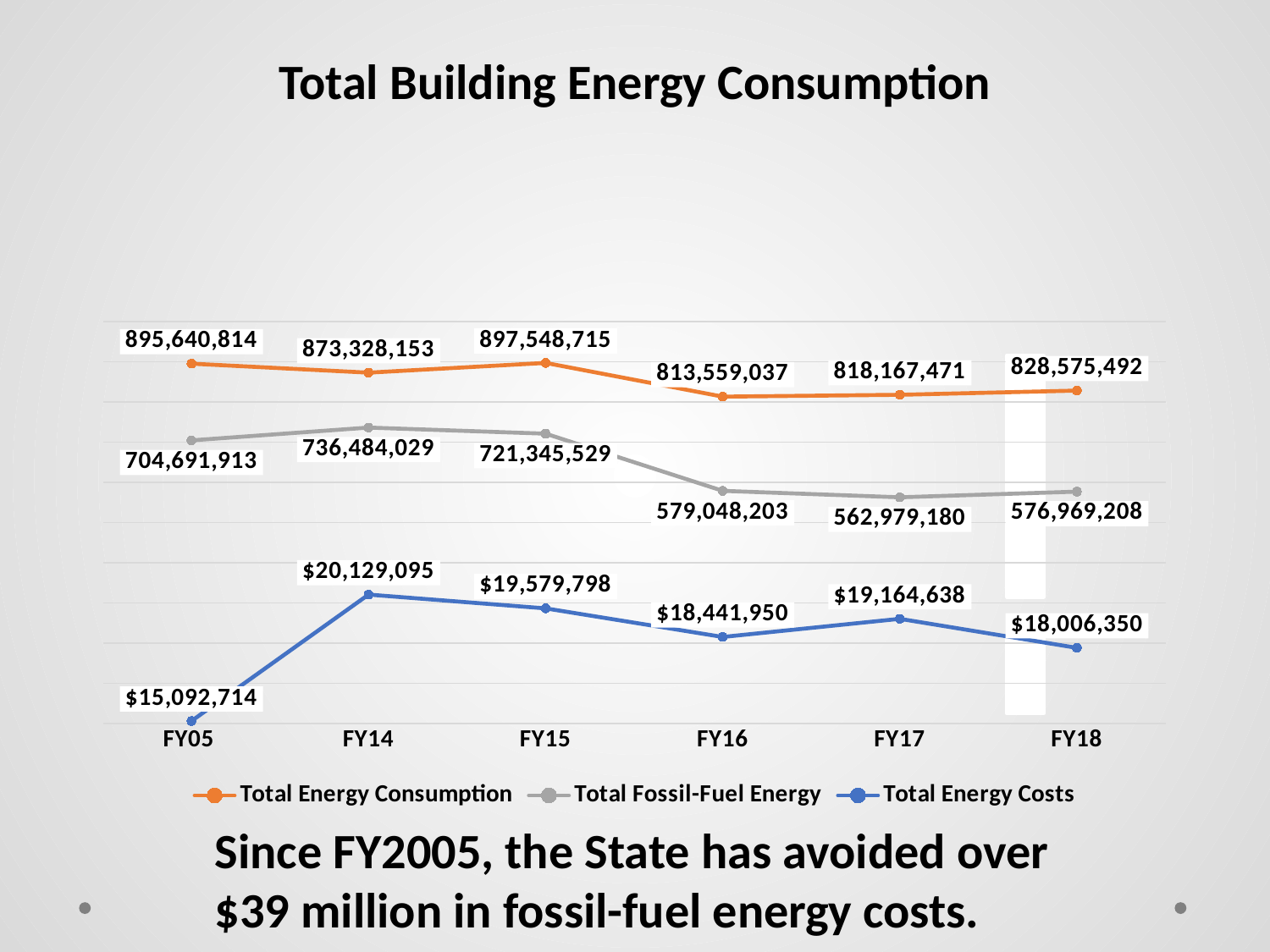
What is the Total Fossil-Fuel Energy value for FY05? 704,691,913 In which fiscal year is Total Energy Costs lowest? FY05 In which fiscal year is Total Fossil-Fuel Energy lowest? FY17 What is the difference between Total Energy Consumption in FY05 and FY18? 67,065,322 In which fiscal year is Total Energy Costs highest? FY14 What is the Total Energy Consumption value for FY16? 813,559,037 How many series does the legend list? 3 What is the Total Energy Costs value for FY17? $19,164,638 What is the difference between Total Fossil-Fuel Energy in FY14 and FY17? 173,504,849 Which is larger: Total Fossil-Fuel Energy in FY14 or in FY16? FY14 How many fiscal years are shown on the x axis? 6 What type of chart is shown on the slide? Line chart